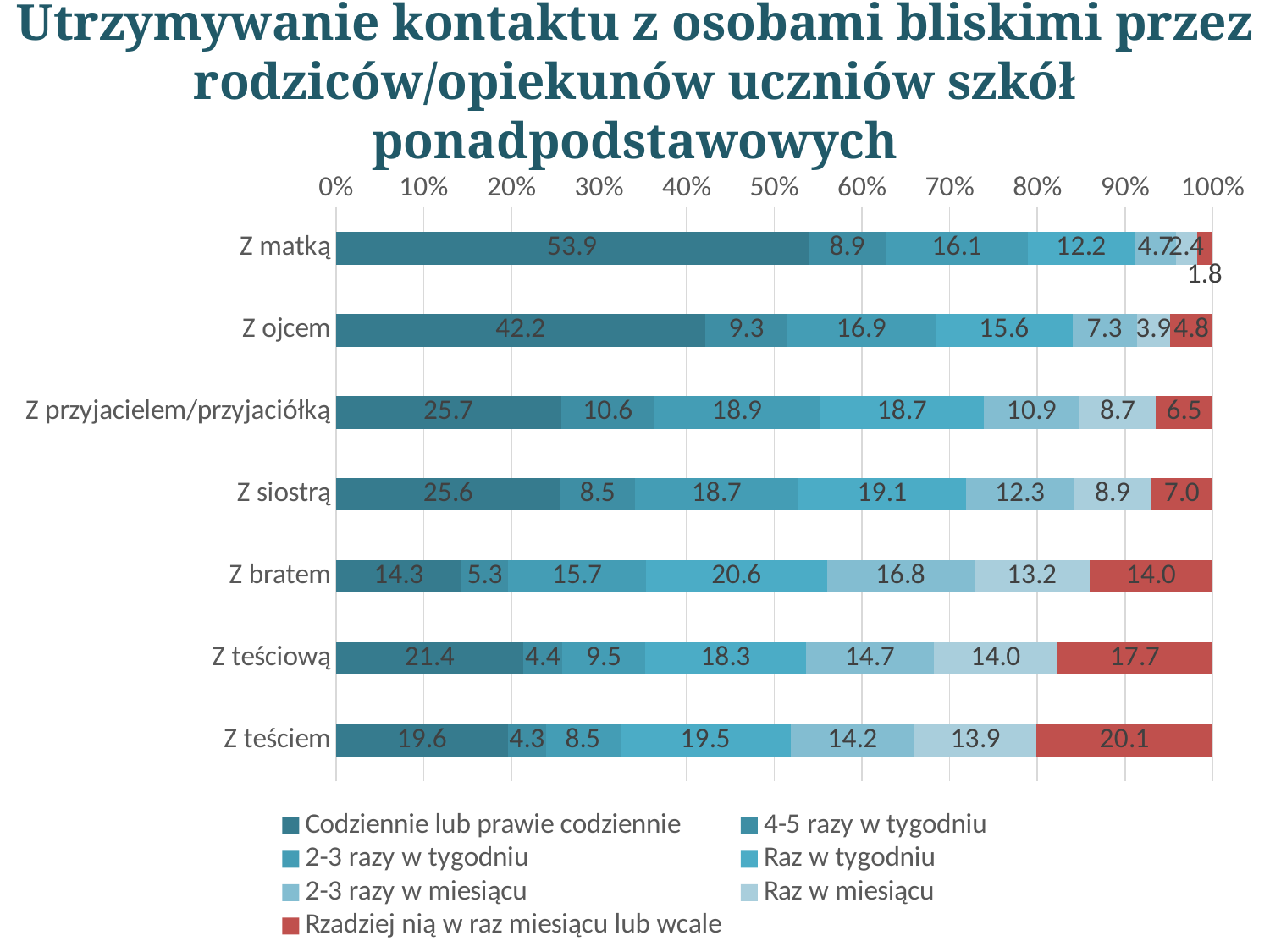
What is the value for "Codziennie lub prawie codziennie" for "Z matką"? 53.9 What is the value for "2-3 razy w tygodniu" for "Z przyjacielem/przyjaciółką"? 18.9 Which series is shown in red in the legend? Rzadziej niż raz w miesiącu lub wcale How many series does the legend list? 7 What is the value for "Rzadziej niż raz w miesiącu lub wcale" for "Z teściem"? 20.1 What kind of chart is shown on the slide? Stacked bar chart What is the difference between the "Codziennie lub prawie codziennie" values for "Z matką" and "Z ojcem"? 11.7 How many categories are shown on the vertical axis? 7 Which category has the highest value for "Codziennie lub prawie codziennie"? Z matką Which is larger for "Rzadziej niż raz w miesiącu lub wcale": "Z teściową" or "Z bratem"? Z teściową What is the value for "Raz w tygodniu" for "Z bratem"? 20.6 Which category has the lowest value for "Rzadziej niż raz w miesiącu lub wcale"? Z matką